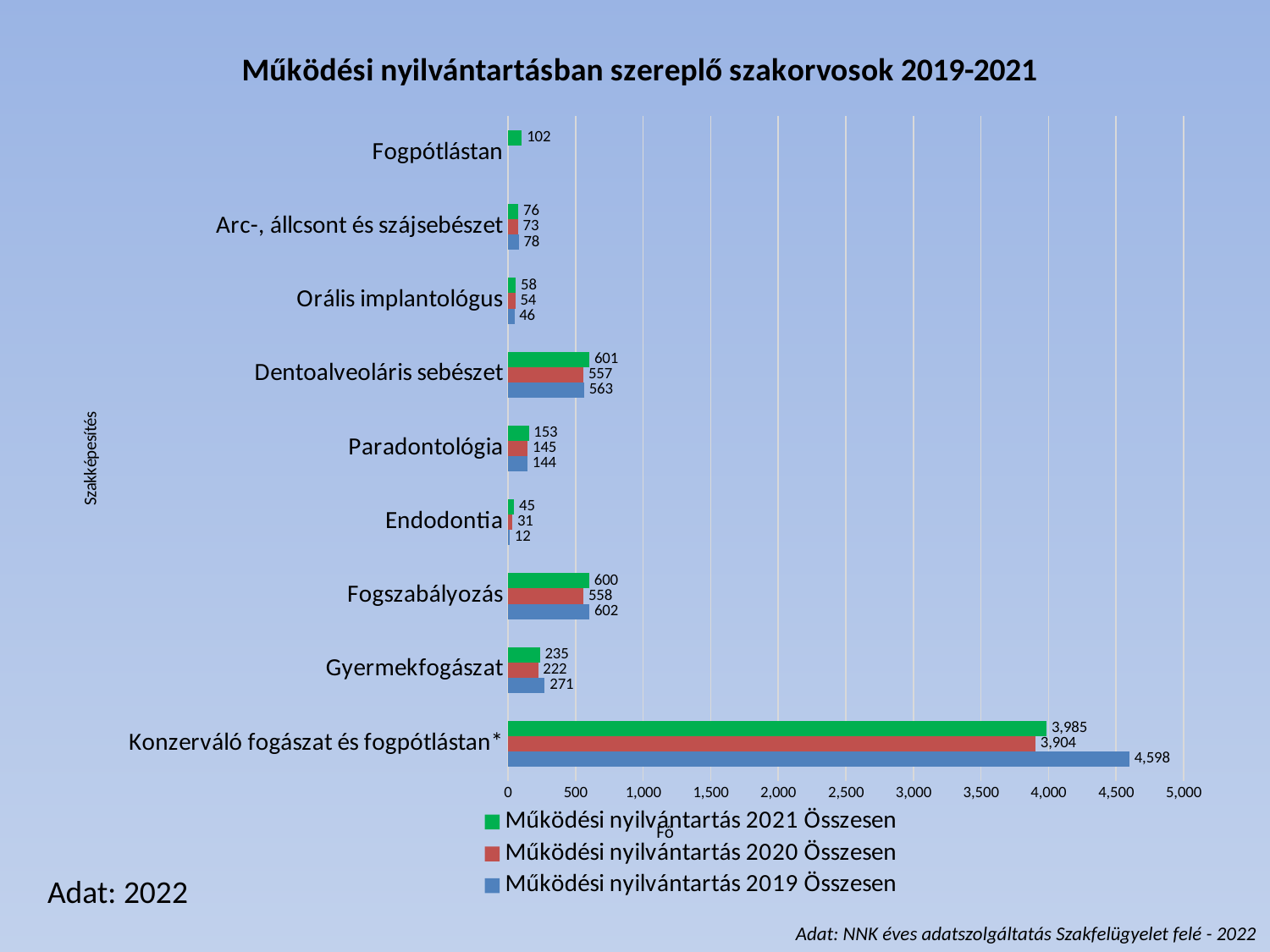
How many categories are shown on the y axis? 9 Which category has the highest value in the Működési nyilvántartás 2021 Összesen series? Konzerváló fogászat és fogpótlástan* Which is larger for Gyermekfogászat: the 2019 value or the 2021 value? 2019 value What is the value for Konzerváló fogászat és fogpótlástan* in the Működési nyilvántartás 2019 Összesen series? 4,598 What is the value for Endodontia in the Működési nyilvántartás 2020 Összesen series? 31 What is the title of the chart? Működési nyilvántartásban szereplő szakorvosok 2019-2021 Is the 2020 value for Dentoalveoláris sebészet greater or less than 500? greater What kind of chart is shown on the slide? Bar chart Which category has the lowest value in the Működési nyilvántartás 2019 Összesen series? Endodontia What is the difference between the 2019 and 2021 values for Konzerváló fogászat és fogpótlástan*? 613 What is the value for Gyermekfogászat in the Működési nyilvántartás 2021 Összesen series? 235 How many series does the legend list? 3